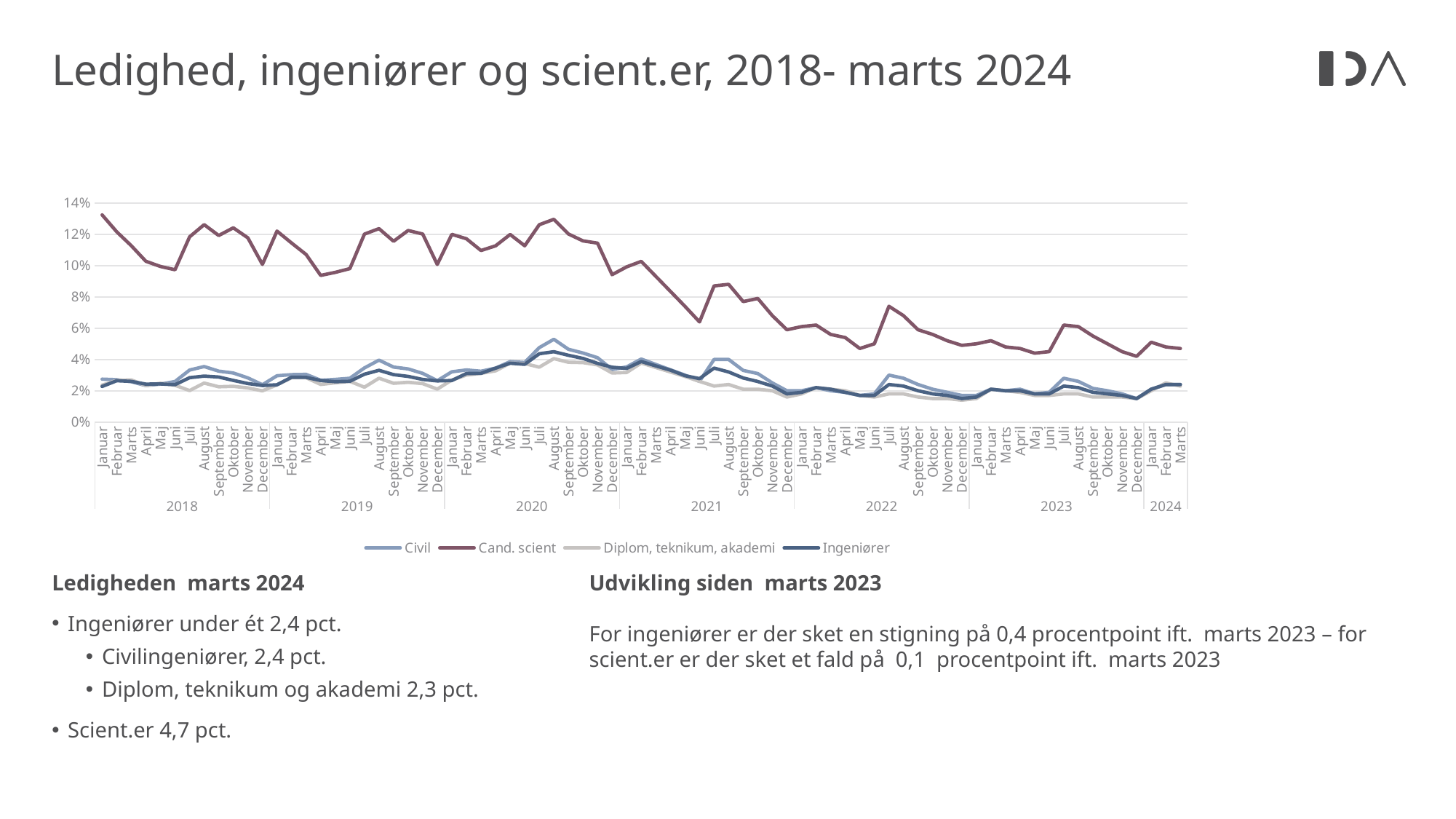
According to the slide, what was the unemployment rate for Scient.er in March 2024? 4,7 pct. What kind of chart is shown on the slide? Line chart According to the slide, what was the unemployment rate for Diplom, teknikum og akademi in March 2024? 2,3 pct. What is the title of the chart slide? Ledighed, ingeniører og scient.er, 2018- marts 2024 Does the Cand. scient line generally rise or fall from 2018 to 2024? Fall According to the slide, what was the unemployment rate for Ingeniører in March 2024? 2,4 pct. Is the value for Cand. scient in March 2024 greater or less than 6%? less What is the difference between the March 2024 unemployment rate for Scient.er and for Ingeniører? 2,3 procentpoint Which series has the highest values throughout the chart? Cand. scient Which is larger in March 2024, the rate for Scient.er or the rate for Ingeniører? Scient.er Is the value for Cand. scient in January 2018 greater or less than 12%? greater How many series does the legend list? 4